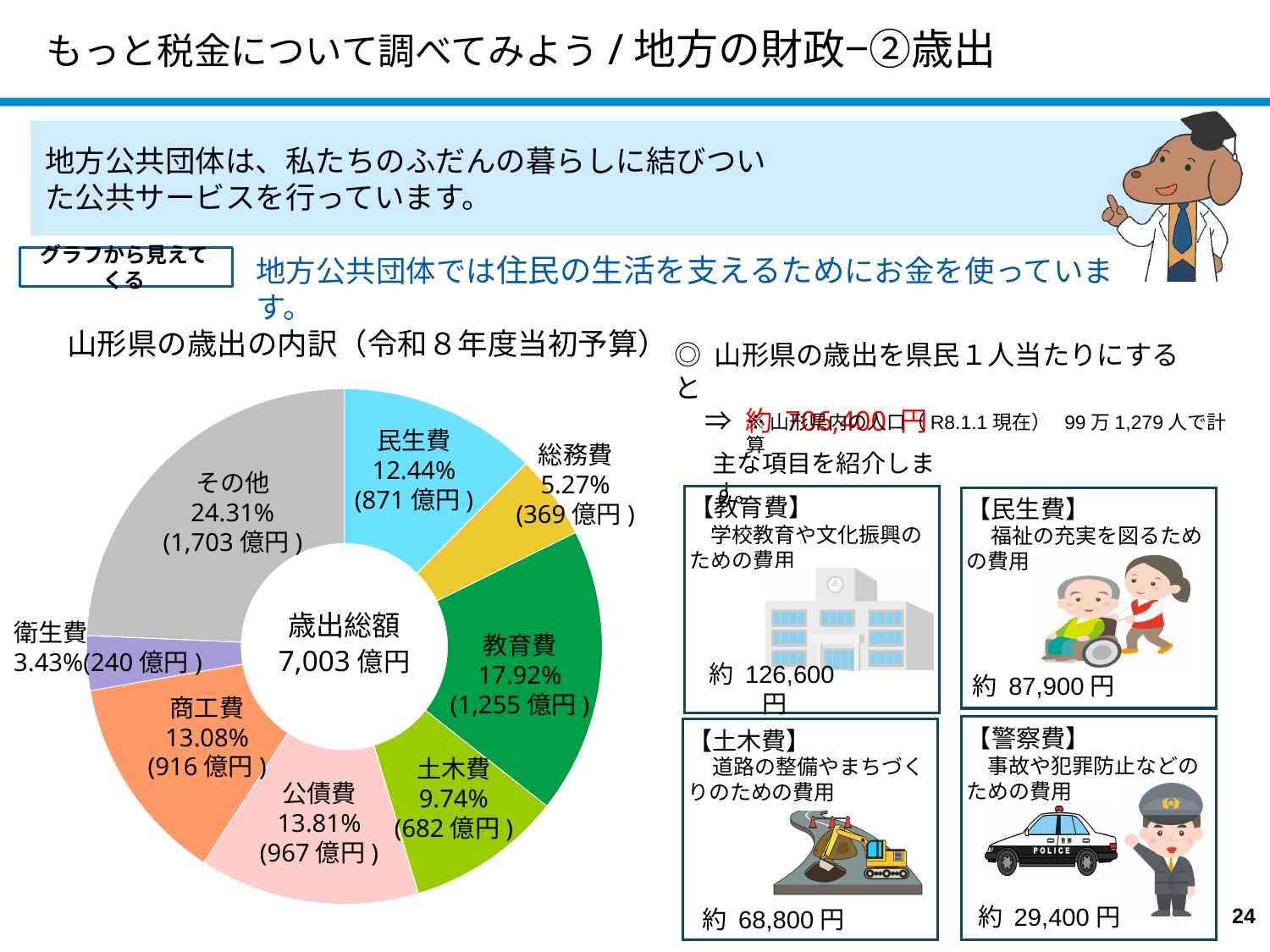
教育費と民生費の金額の差はいくらですか。 384 億円 このグラフはどのような種類のグラフですか。 円グラフ（ドーナツグラフ） グラフの中央に示されている歳出総額はいくらですか。 7,003 億円 公債費の割合は何％ですか。 13.81% 総務費の割合は何％ですか。 5.27% グラフの中で最も割合が小さい項目はどれですか。 衛生費 グラフのタイトルは何ですか。 山形県の歳出の内訳（令和８年度当初予算） 教育費の割合は何％ですか。 17.92% 商工費と土木費では、どちらの割合が大きいですか。 商工費 グラフの中で最も割合が大きい項目はどれですか。 その他 グラフには何個の項目がありますか。 8 民生費の金額はいくらですか。 871 億円